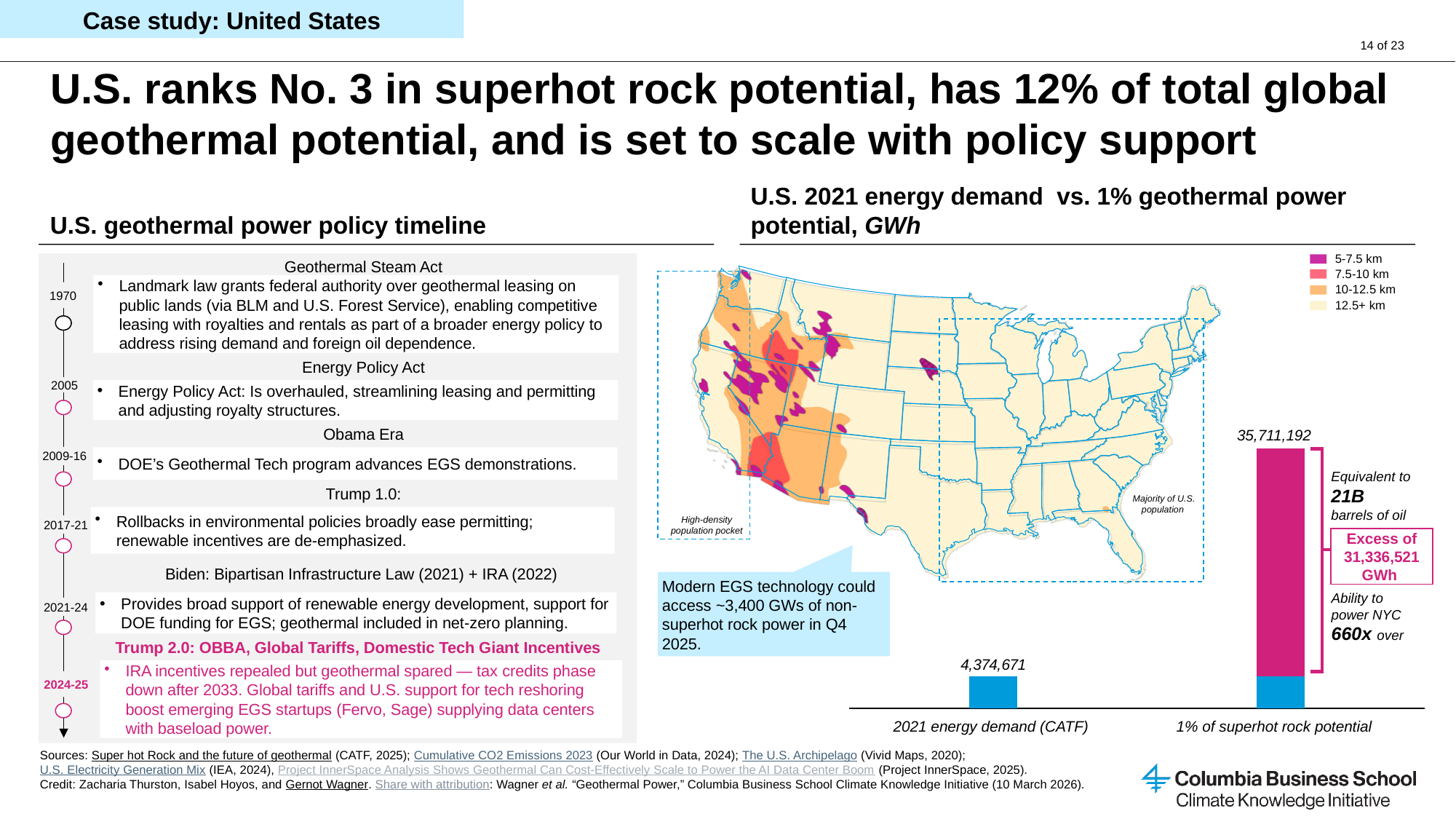
In the bar chart 'U.S. 2021 energy demand vs. 1% geothermal power potential, GWh', what unit are the values in? GWh How many categories are shown in the bar chart 'U.S. 2021 energy demand vs. 1% geothermal power potential, GWh'? 2 In the bar chart 'U.S. 2021 energy demand vs. 1% geothermal power potential, GWh', what excess in GWh is labelled on the 1% of superhot rock potential bar? Excess of 31,336,521 GWh In the bar chart 'U.S. 2021 energy demand vs. 1% geothermal power potential, GWh', which category has the lowest value? 2021 energy demand (CATF) What kind of chart is 'U.S. 2021 energy demand vs. 1% geothermal power potential, GWh'? Bar chart In the bar chart 'U.S. 2021 energy demand vs. 1% geothermal power potential, GWh', which is larger: 2021 energy demand (CATF) or 1% of superhot rock potential? 1% of superhot rock potential In the bar chart 'U.S. 2021 energy demand vs. 1% geothermal power potential, GWh', what is the difference between 1% of superhot rock potential and 2021 energy demand (CATF)? 31,336,521 On the U.S. map, which depth range does the darkest (magenta) colour in the legend represent? 5-7.5 km In the bar chart 'U.S. 2021 energy demand vs. 1% geothermal power potential, GWh', which category has the highest value? 1% of superhot rock potential In the bar chart 'U.S. 2021 energy demand vs. 1% geothermal power potential, GWh', what is the value for 1% of superhot rock potential? 35,711,192 How many depth categories does the legend of the U.S. map list? 4 In the bar chart 'U.S. 2021 energy demand vs. 1% geothermal power potential, GWh', what is the value for 2021 energy demand (CATF)? 4,374,671